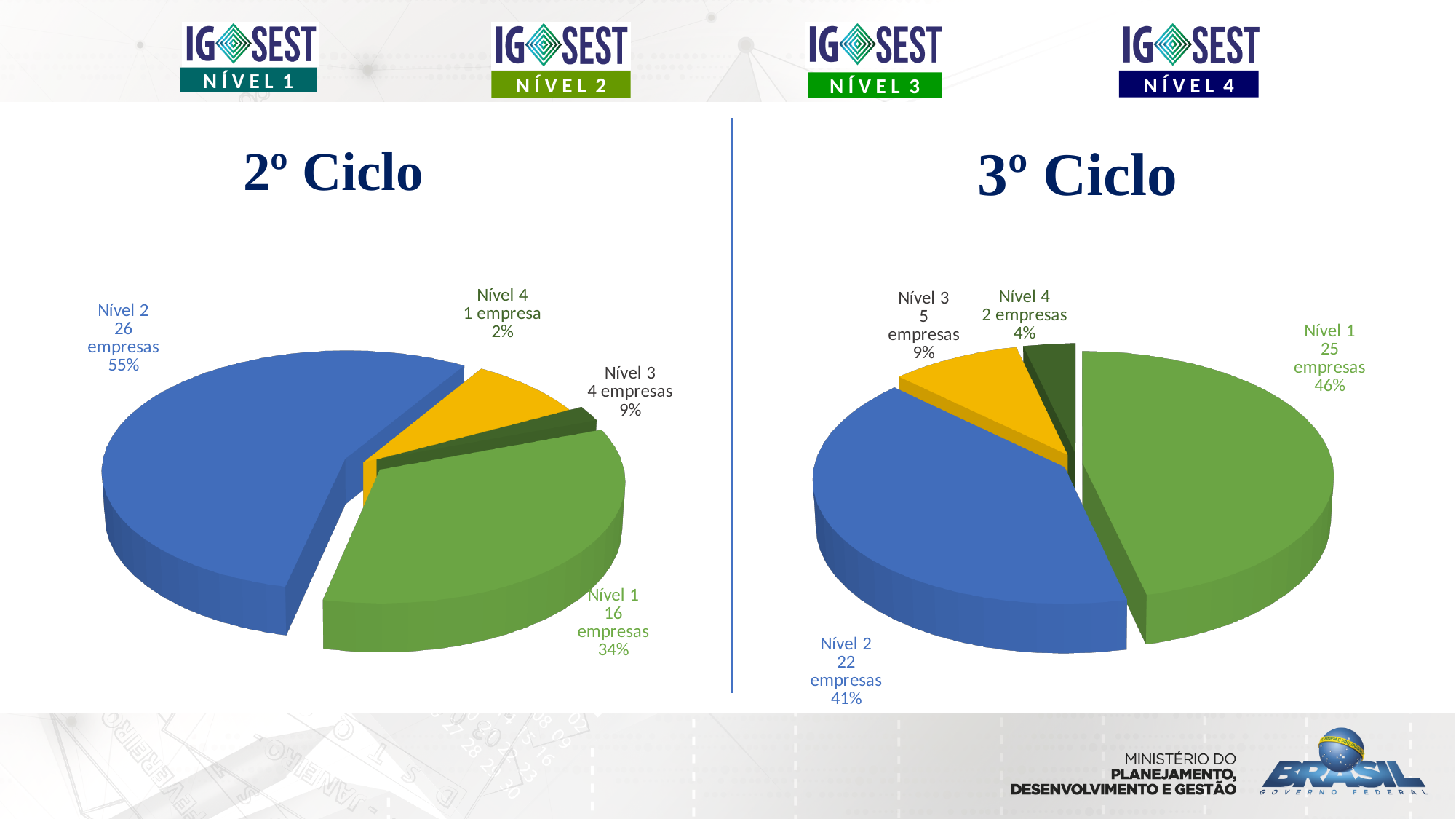
In the 3º Ciclo chart, what is the total number of empresas across all four Níveis? 54 In the 3º Ciclo chart, how many empresas are in Nível 1? 25 In the 3º Ciclo chart, what share of the pie does Nível 2 represent? 41% In the 2º Ciclo chart, what share of the pie does Nível 1 represent? 34% In the 2º Ciclo chart, which Nível has the smallest slice? Nível 4 What type of chart is used for the 3º Ciclo data? Pie chart In the 2º Ciclo chart, how many empresas are in Nível 2? 26 In the 3º Ciclo chart, which Nível has the largest slice? Nível 1 In the 3º Ciclo chart, which has more empresas, Nível 3 or Nível 4? Nível 3 In the 2º Ciclo chart, what is the difference in number of empresas between Nível 2 and Nível 1? 10 How many slices does the 2º Ciclo pie chart have? 4 In the 2º Ciclo chart, which Nível has the largest slice? Nível 2